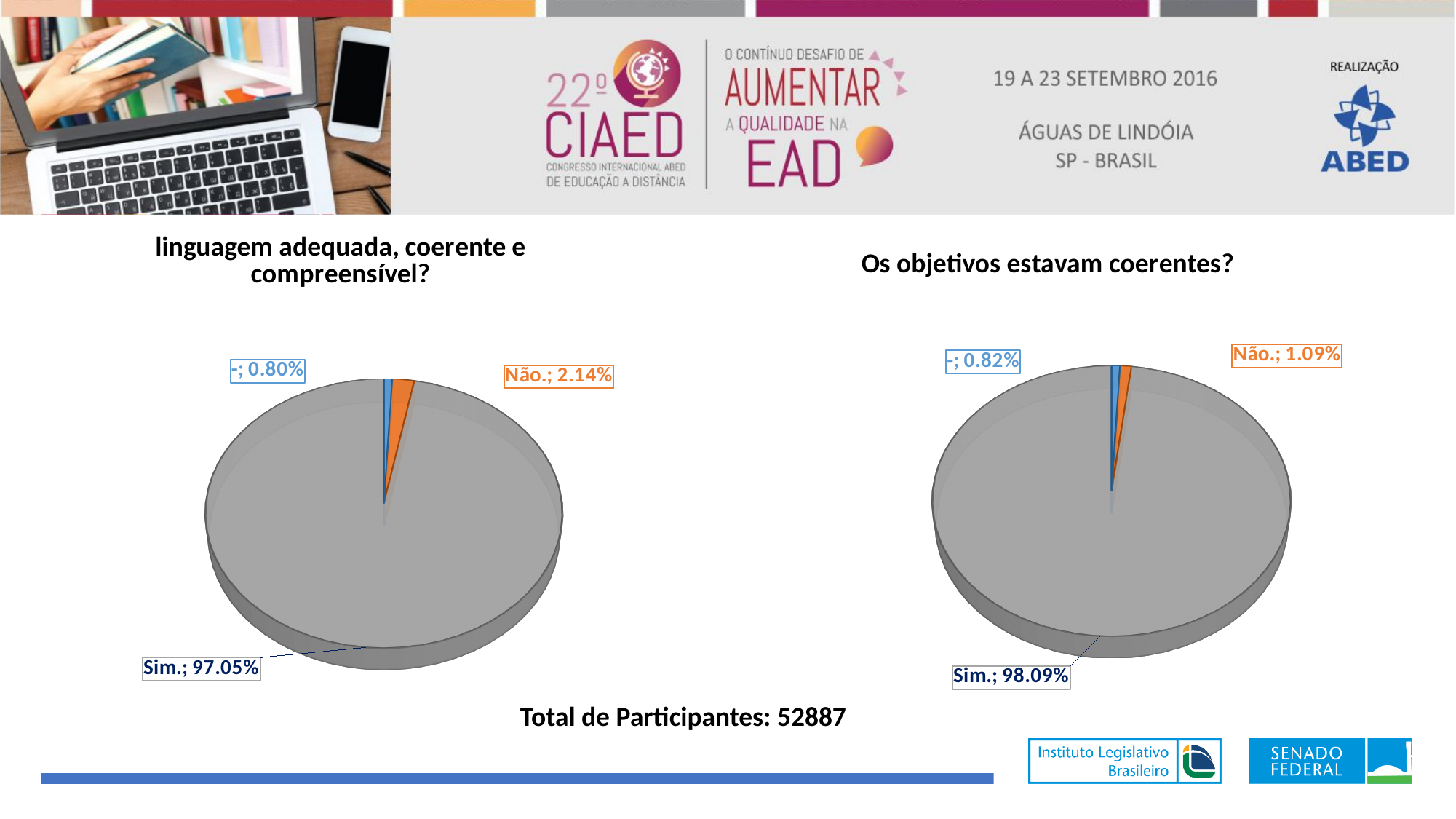
What kind of chart is used on the left, titled "linguagem adequada, coerente e compreensível?"? pie chart How many slices does the right chart ("Os objetivos estavam coerentes?") have? 3 Which is larger: the "Não." share in the left chart or the "Não." share in the right chart? the left chart (2.14%) In the right chart ("Os objetivos estavam coerentes?"), what share does "Sim." have? 98.09% In the left chart ("linguagem adequada, coerente e compreensível?"), what is the difference between the "Não." and "-" slices? 1.34% In the right chart ("Os objetivos estavam coerentes?"), what is the value for the "-" slice? 0.82% In the left chart ("linguagem adequada, coerente e compreensível?"), what share does "Sim." have? 97.05% In the left chart ("linguagem adequada, coerente e compreensível?"), what is the value for "Não."? 2.14% In the right chart ("Os objetivos estavam coerentes?"), what is the value for "Não."? 1.09% In the right chart ("Os objetivos estavam coerentes?"), which slice is the largest? Sim. In the left chart ("linguagem adequada, coerente e compreensível?"), what is the value for the "-" slice? 0.80% In the left chart ("linguagem adequada, coerente e compreensível?"), which slice is the smallest? -